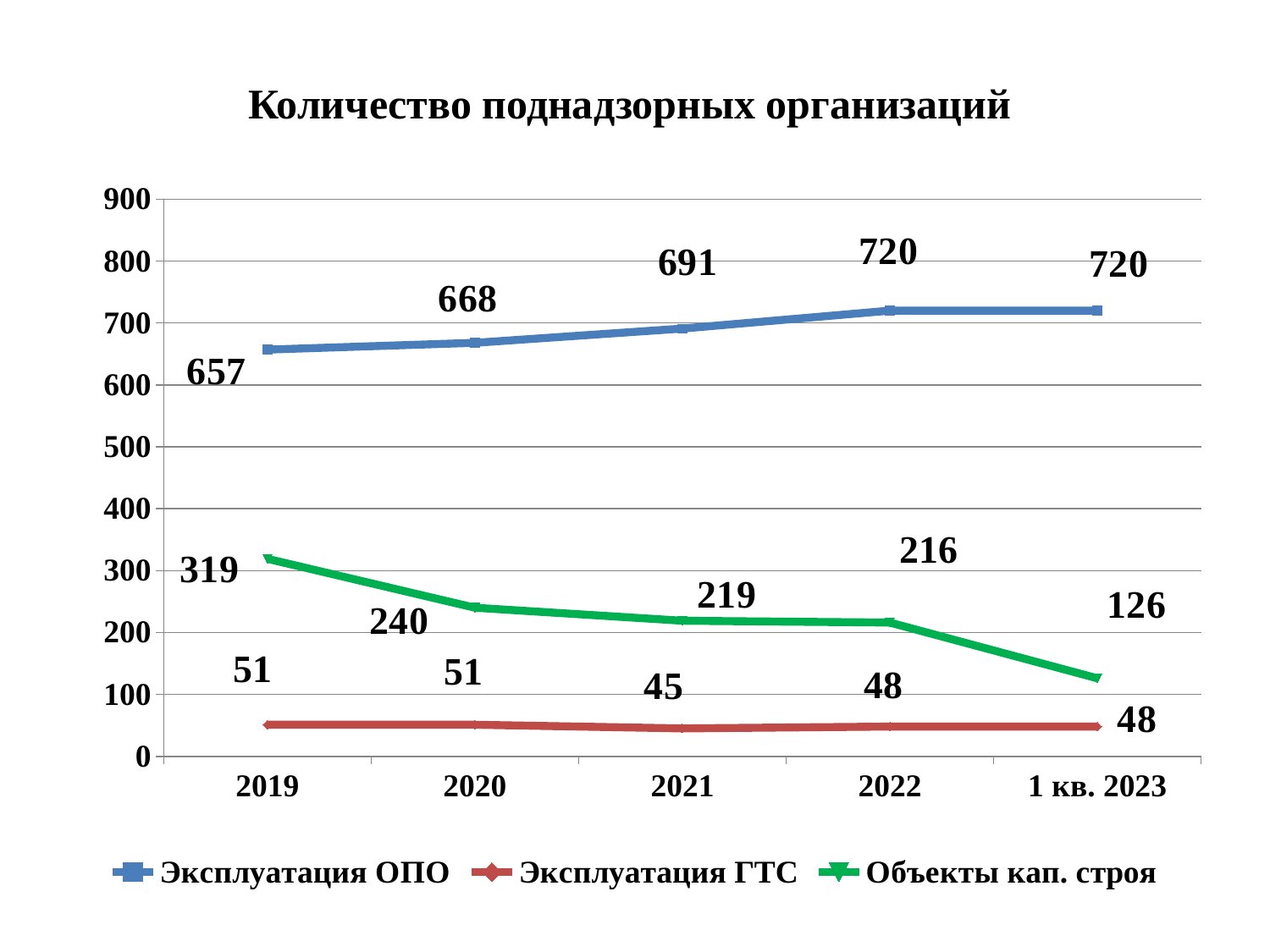
What is the value for Объекты кап. строя in 2020? 240 Does the Объекты кап. строя series rise or fall from 2019 to 1 кв. 2023? fall How many series does the legend list? 3 Which is larger: Объекты кап. строя in 2021 or in 2022? 2021 What is the value for Эксплуатация ОПО in 2021? 691 What kind of chart is shown on the slide? line chart In which year does Объекты кап. строя reach its highest value? 2019 How many periods are shown on the x axis? 5 What is the difference between the Эксплуатация ОПО values in 2022 and 2019? 63 What is the title of the chart? Количество поднадзорных организаций What is the value for Эксплуатация ГТС in 2021? 45 Which period has the lowest value for Объекты кап. строя? 1 кв. 2023